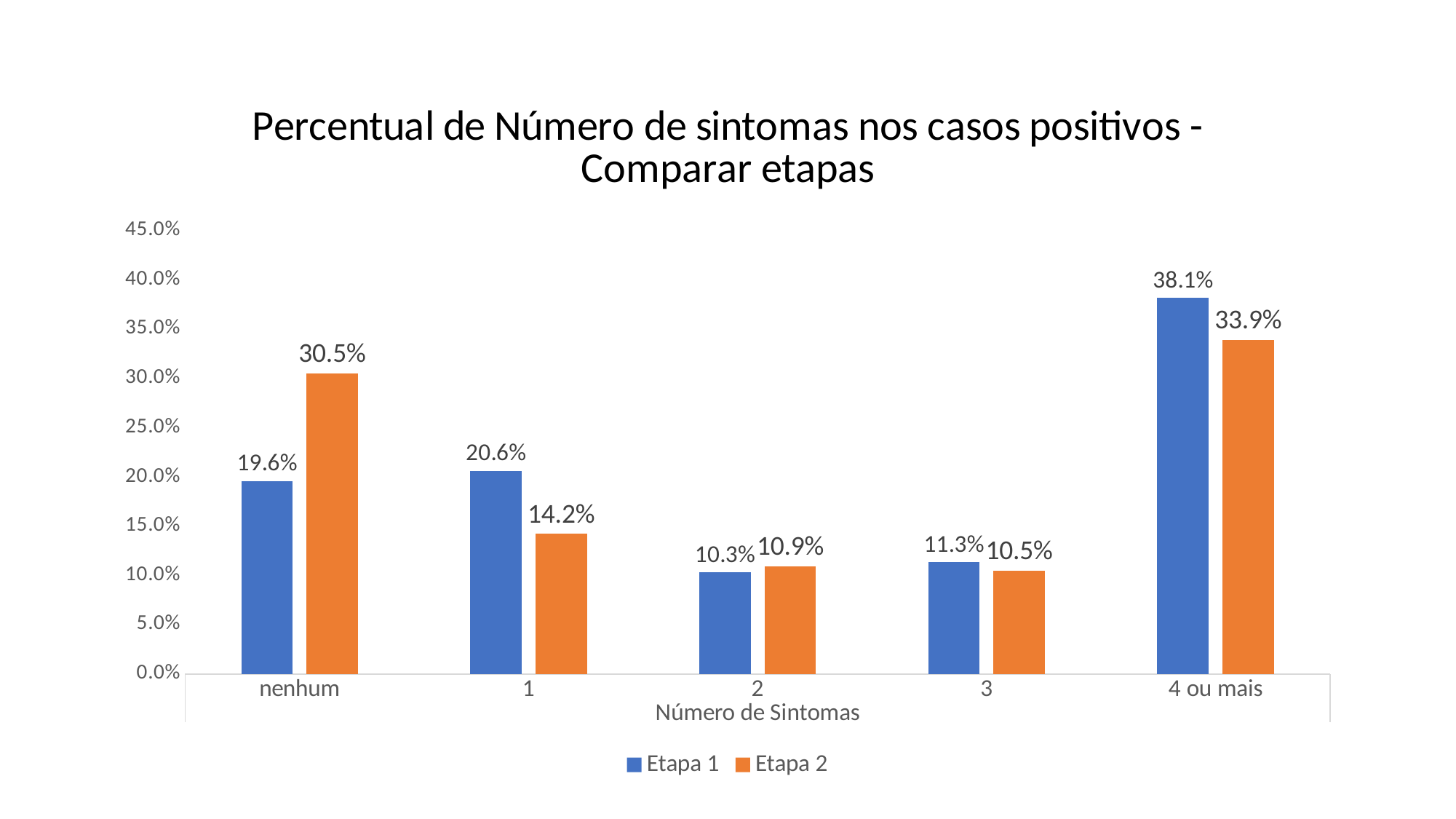
What is the Etapa 2 value for category '1'? 14.2% What kind of chart is shown on the slide? Bar chart What is the x-axis title of the chart? Número de Sintomas For category '1', which series has the larger value, Etapa 1 or Etapa 2? Etapa 1 How many series does the legend list? 2 What is the difference between Etapa 1 and Etapa 2 for '4 ou mais'? 4.2% How many categories are shown on the x axis? 5 What is the difference between the Etapa 2 and Etapa 1 values for 'nenhum'? 10.9% Which category has the lowest Etapa 1 value? 2 What is the Etapa 2 value for the '4 ou mais' category? 33.9% What is the Etapa 1 value for the 'nenhum' category? 19.6% Which category has the highest Etapa 1 value? 4 ou mais